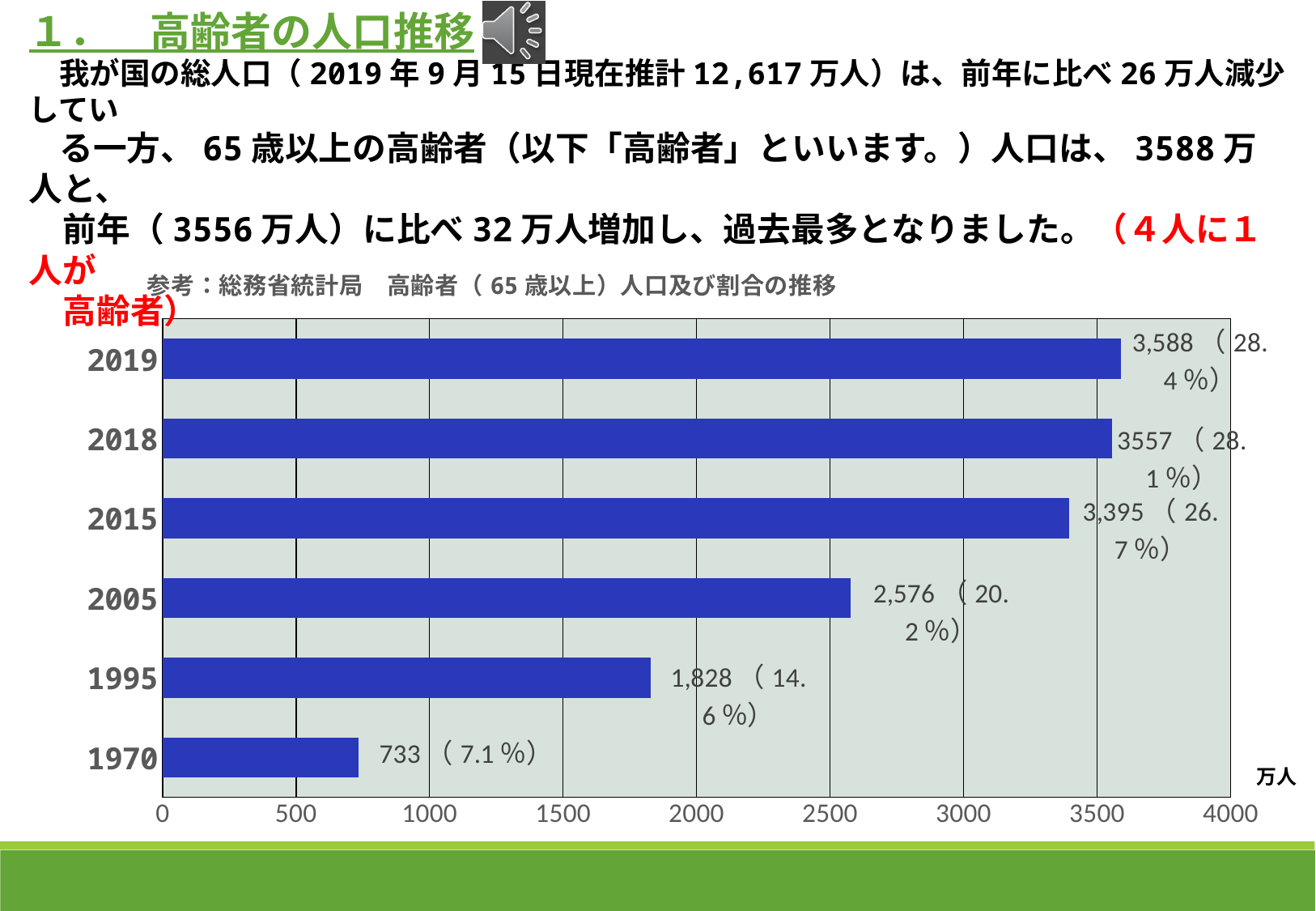
What unit is shown next to the x axis of the chart? 万人 What is the difference between the population values for 2015 and 2005? 819 Which year has the highest value? 2019 Which year has the lowest value? 1970 What kind of chart is shown on the slide? bar chart What is the value labelled for 2019? 3,588 (28.4%) What is the population value labelled for 1995? 1,828 How many years (categories) are plotted in the chart? 6 Which is larger, the value for 2015 or the value for 1995? 2015 What is the value labelled for 1970? 733 (7.1%) What percentage is shown in the label for 2005? 20.2% Is the value for 2005 greater or less than 2500? greater